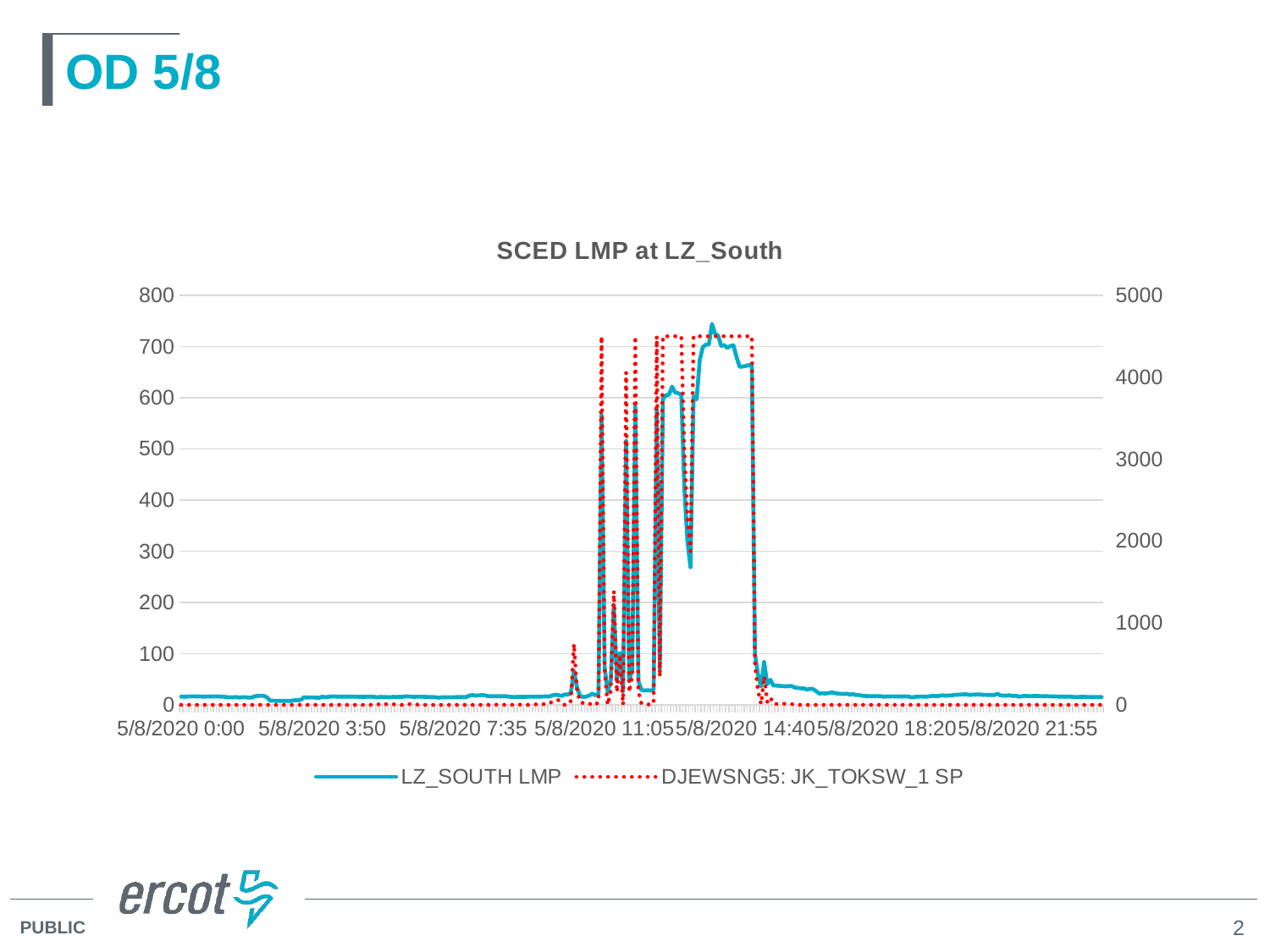
Does LZ_SOUTH LMP rise or fall between 5/8/2020 14:40 and 5/8/2020 18:20? fall Is the peak value of DJEWSNG5: JK_TOKSW_1 SP greater or less than 4000 on the right axis? greater Is the value of LZ_SOUTH LMP at 5/8/2020 7:35 greater or less than 200? less How many time labels are shown on the x axis? 7 How many series does the legend list? 2 What is the title of the chart? SCED LMP at LZ_South What kind of chart is shown on the slide? line chart Is the value of LZ_SOUTH LMP at 5/8/2020 3:50 greater or less than 100? less Which series is drawn as a red dotted line? DJEWSNG5: JK_TOKSW_1 SP